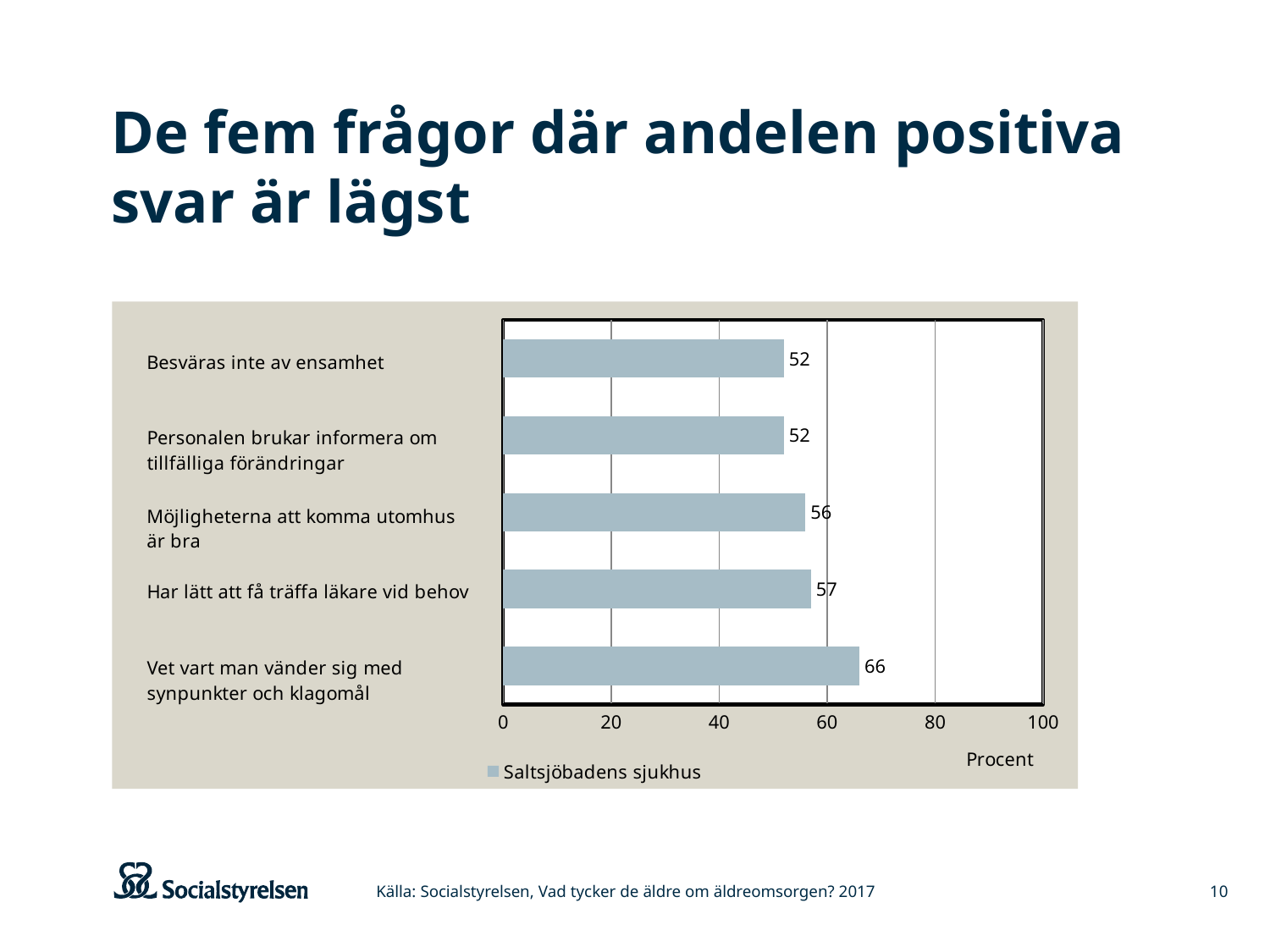
What is the value for "Möjligheterna att komma utomhus är bra"? 56 What kind of chart is shown on the slide? Bar chart Which is larger, the value for "Har lätt att få träffa läkare vid behov" or the value for "Personalen brukar informera om tillfälliga förändringar"? Har lätt att få träffa läkare vid behov What is the value for "Har lätt att få träffa läkare vid behov"? 57 What is the difference between the values for "Vet vart man vänder sig med synpunkter och klagomål" and "Besväras inte av ensamhet"? 14 What is the series name shown in the legend? Saltsjöbadens sjukhus What is the value for "Vet vart man vänder sig med synpunkter och klagomål"? 66 How many series does the legend list? 1 Is the value for "Vet vart man vänder sig med synpunkter och klagomål" greater or less than 60? greater What is the value for "Besväras inte av ensamhet"? 52 How many categories are shown in the chart? 5 Which category has the highest value? Vet vart man vänder sig med synpunkter och klagomål